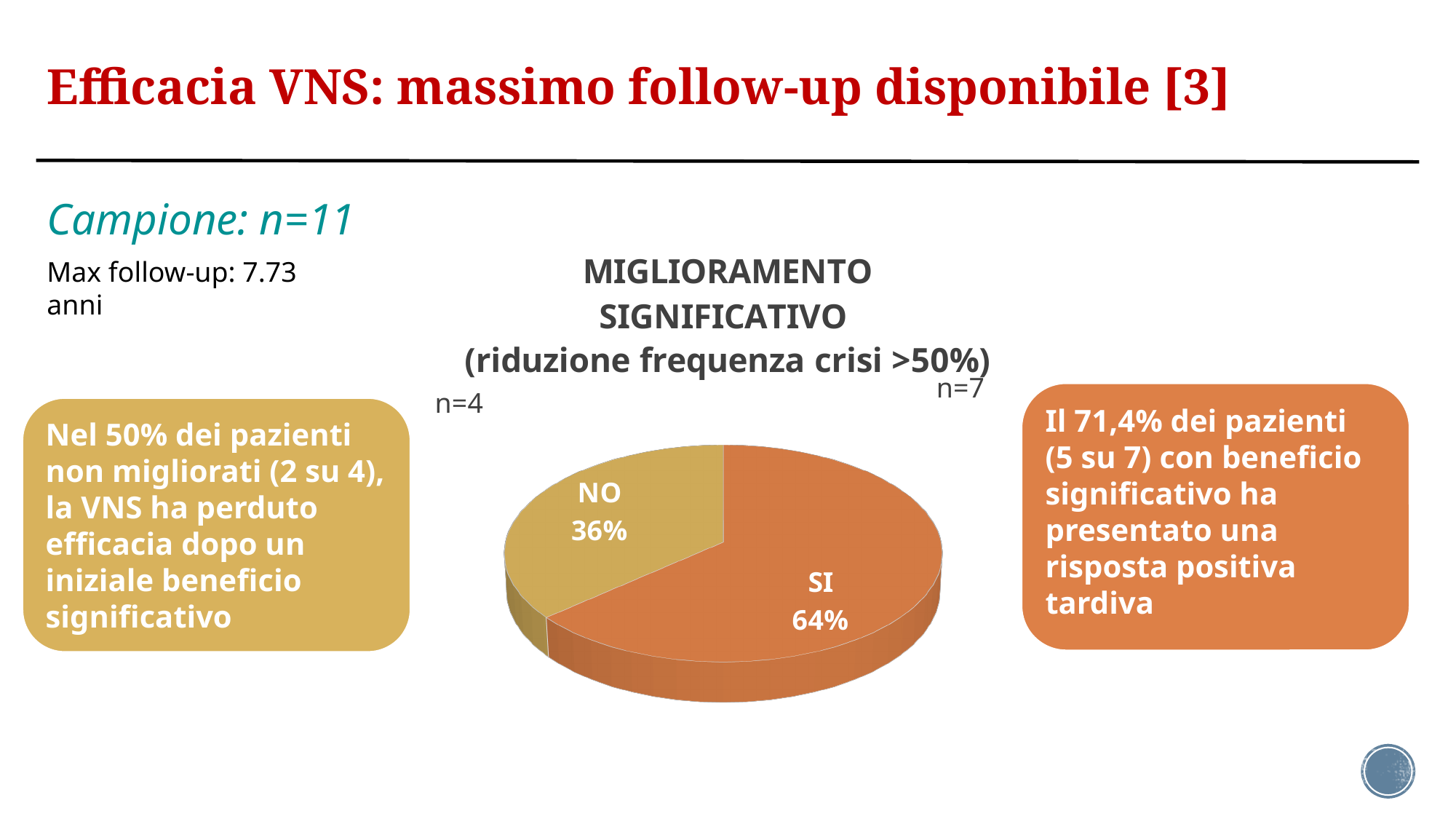
What colour is the SI slice of the pie chart? orange Which slice is larger, SI or NO? SI What is the title of the pie chart? MIGLIORAMENTO SIGNIFICATIVO (riduzione frequenza crisi >50%) What is the difference in percentage points between the SI and NO slices? 28 What kind of chart is shown on the slide? pie chart What is the n value shown next to the SI slice? n=7 What is the n value shown next to the NO slice? n=4 Which slice of the pie is the largest? SI What percentage of the pie is labelled NO? 36% What percentage of the pie is labelled SI? 64% Which slice of the pie is the smallest? NO How many slices does the pie chart have? 2